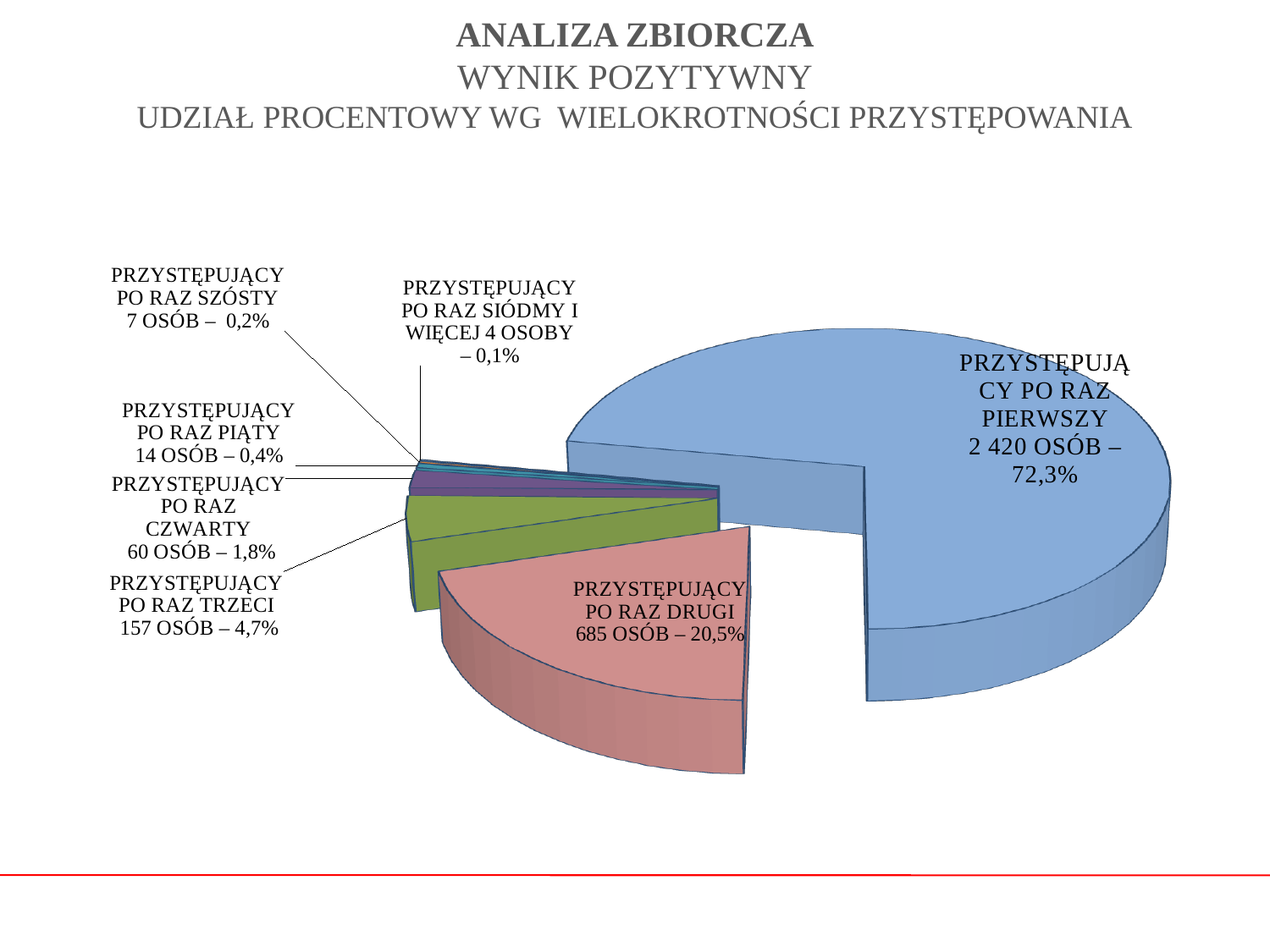
What percentage share is shown for PRZYSTĘPUJĄCY PO RAZ PIĄTY? 0,4% How many slices does the pie chart have? 7 Which category has the largest slice of the pie? PRZYSTĘPUJĄCY PO RAZ PIERWSZY Which category has the smallest slice of the pie? PRZYSTĘPUJĄCY PO RAZ SIÓDMY I WIĘCEJ What kind of chart is shown on the slide? pie chart How many people (OSÓB) are shown for PRZYSTĘPUJĄCY PO RAZ CZWARTY? 60 What is the difference in number of people between PRZYSTĘPUJĄCY PO RAZ PIERWSZY and PRZYSTĘPUJĄCY PO RAZ DRUGI? 1 735 What is the first line of the slide title? ANALIZA ZBIORCZA What percentage share is shown for PRZYSTĘPUJĄCY PO RAZ PIERWSZY? 72,3% What percentage share is shown for PRZYSTĘPUJĄCY PO RAZ TRZECI? 4,7% How many people (OSÓB) are shown for PRZYSTĘPUJĄCY PO RAZ DRUGI? 685 Which has more people: PRZYSTĘPUJĄCY PO RAZ TRZECI or PRZYSTĘPUJĄCY PO RAZ CZWARTY? PRZYSTĘPUJĄCY PO RAZ TRZECI